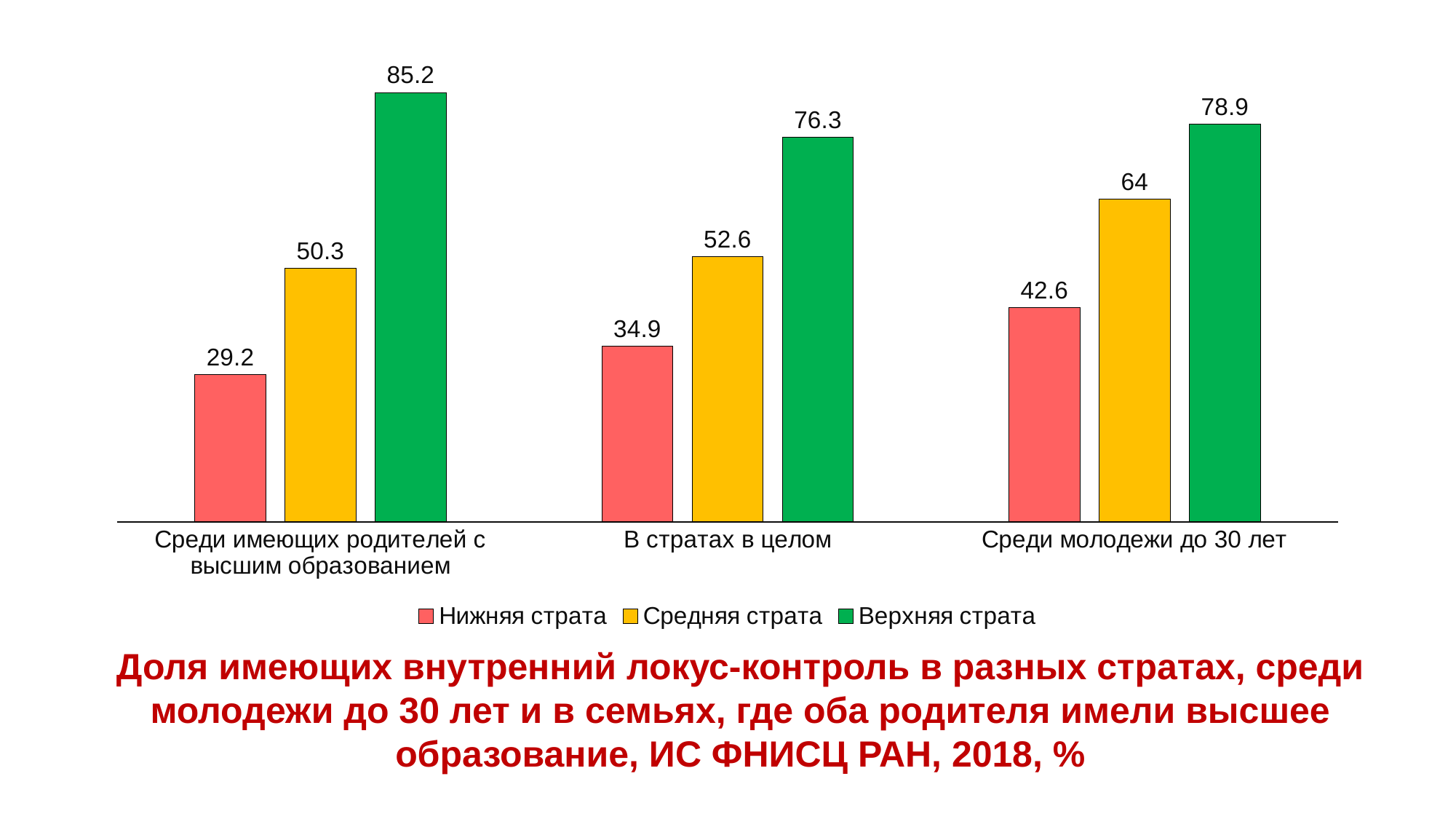
What is the difference between the Верхняя страта and Нижняя страта values in the category 'Среди имеющих родителей с высшим образованием'? 56 What is the difference between the Средняя страта and Нижняя страта values in the category 'Среди молодежи до 30 лет'? 21.4 What is the value for Нижняя страта in the category 'В стратах в целом'? 34.9 What is the value for Средняя страта in the category 'Среди молодежи до 30 лет'? 64 Which category has the lowest value for Верхняя страта? В стратах в целом What colour are the bars for Верхняя страта? Green What kind of chart is shown on the slide? Bar chart What is the value for Верхняя страта in the category 'Среди имеющих родителей с высшим образованием'? 85.2 How many series does the legend list? 3 Which category has the highest value for Нижняя страта? Среди молодежи до 30 лет How many categories are shown on the x axis? 3 Which is larger: the Средняя страта value for 'В стратах в целом' or for 'Среди молодежи до 30 лет'? Среди молодежи до 30 лет